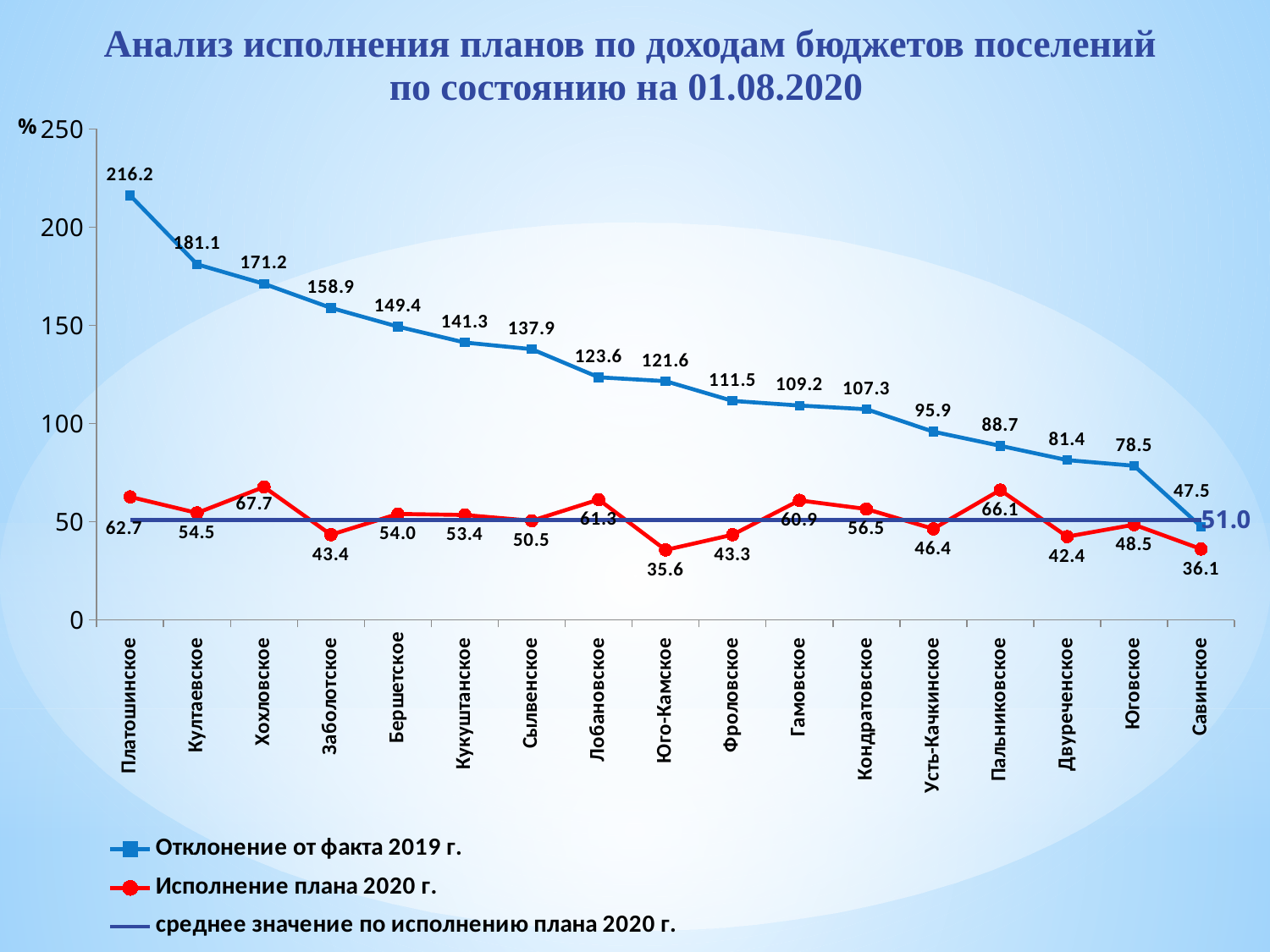
How many settlements are shown on the x axis? 17 What kind of chart is shown on the slide? line chart Which settlement has the highest value of "Исполнение плана 2020 г."? Хохловское What is the value of "Отклонение от факта 2019 г." for Платошинское? 216.2 How many series does the legend list? 3 Which is larger: the "Исполнение плана 2020 г." value for Гамовское or for Кондратовское? Гамовское What is the value of "Исполнение плана 2020 г." for Пальниковское? 66.1 What is the value of "Исполнение плана 2020 г." for Юго-Камское? 35.6 Is the "Отклонение от факта 2019 г." value for Сылвенское greater or less than 150? less What is the difference between the "Отклонение от факта 2019 г." values for Платошинское and Култаевское? 35.1 What is the value of the line "среднее значение по исполнению плана 2020 г."? 51.0 Which settlement has the lowest value of "Отклонение от факта 2019 г."? Савинское